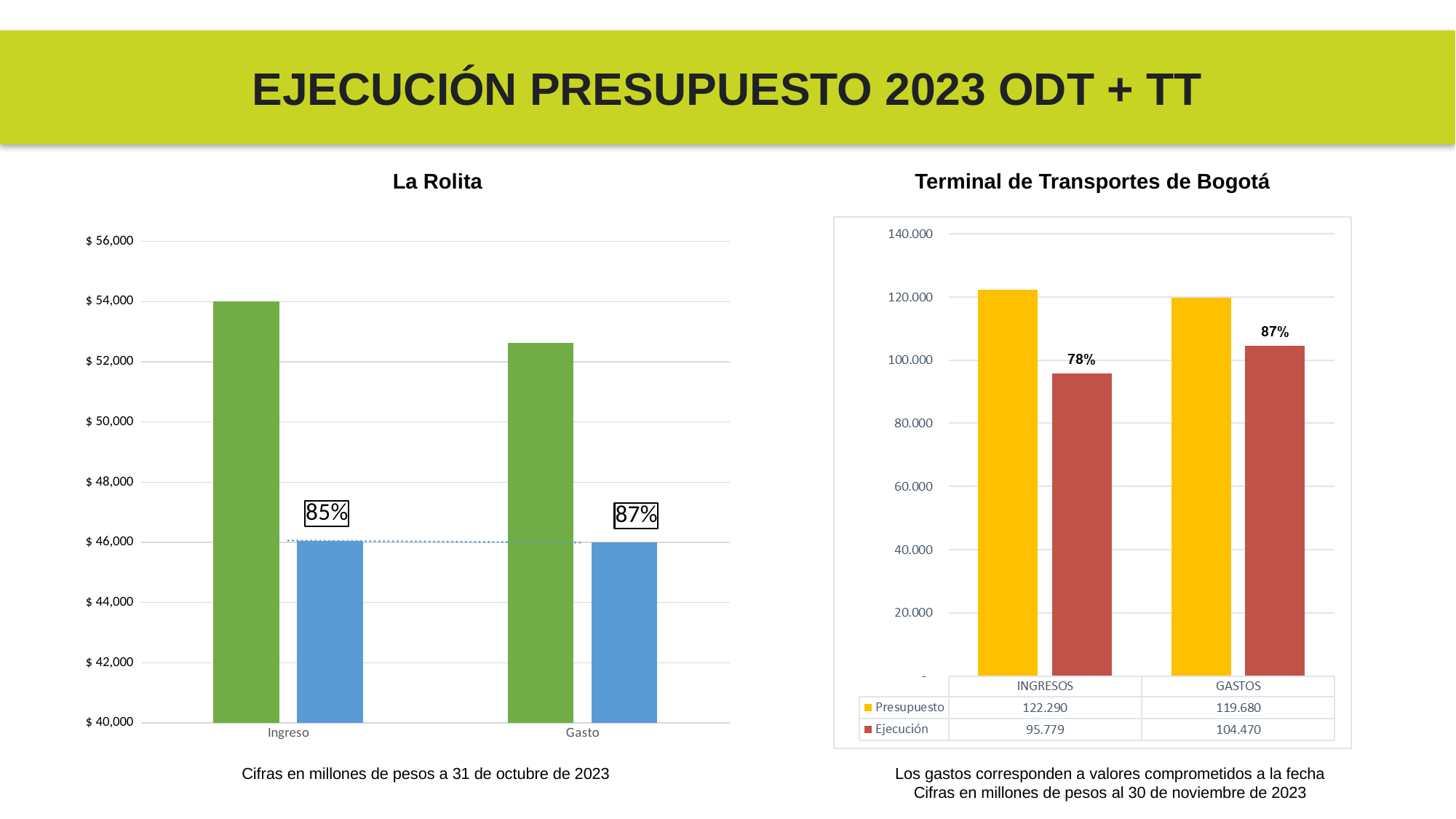
In the Terminal de Transportes de Bogotá chart, what is the difference between Presupuesto and Ejecución for INGRESOS? 26.511 In the Terminal de Transportes de Bogotá chart, how many series does the legend list? 2 In the Terminal de Transportes de Bogotá chart, what is the Presupuesto value for INGRESOS? 122.290 In the La Rolita chart, is the value of the green Ingreso bar greater or less than $ 50,000? greater How many categories are shown on the x axis of the La Rolita chart? 2 In the Terminal de Transportes de Bogotá chart, which category has the higher Presupuesto value, INGRESOS or GASTOS? INGRESOS In the Terminal de Transportes de Bogotá chart, what is the difference between Presupuesto and Ejecución for GASTOS? 15.210 In the Terminal de Transportes de Bogotá chart, what percentage label is shown above the Ejecución bar for INGRESOS? 78% In the La Rolita chart, what percentage label is shown for Gasto? 87% In the Terminal de Transportes de Bogotá chart, what is the Ejecución value for GASTOS? 104.470 What kind of chart is the La Rolita chart? bar chart In the La Rolita chart, is the value of the blue Gasto bar greater or less than $ 48,000? less